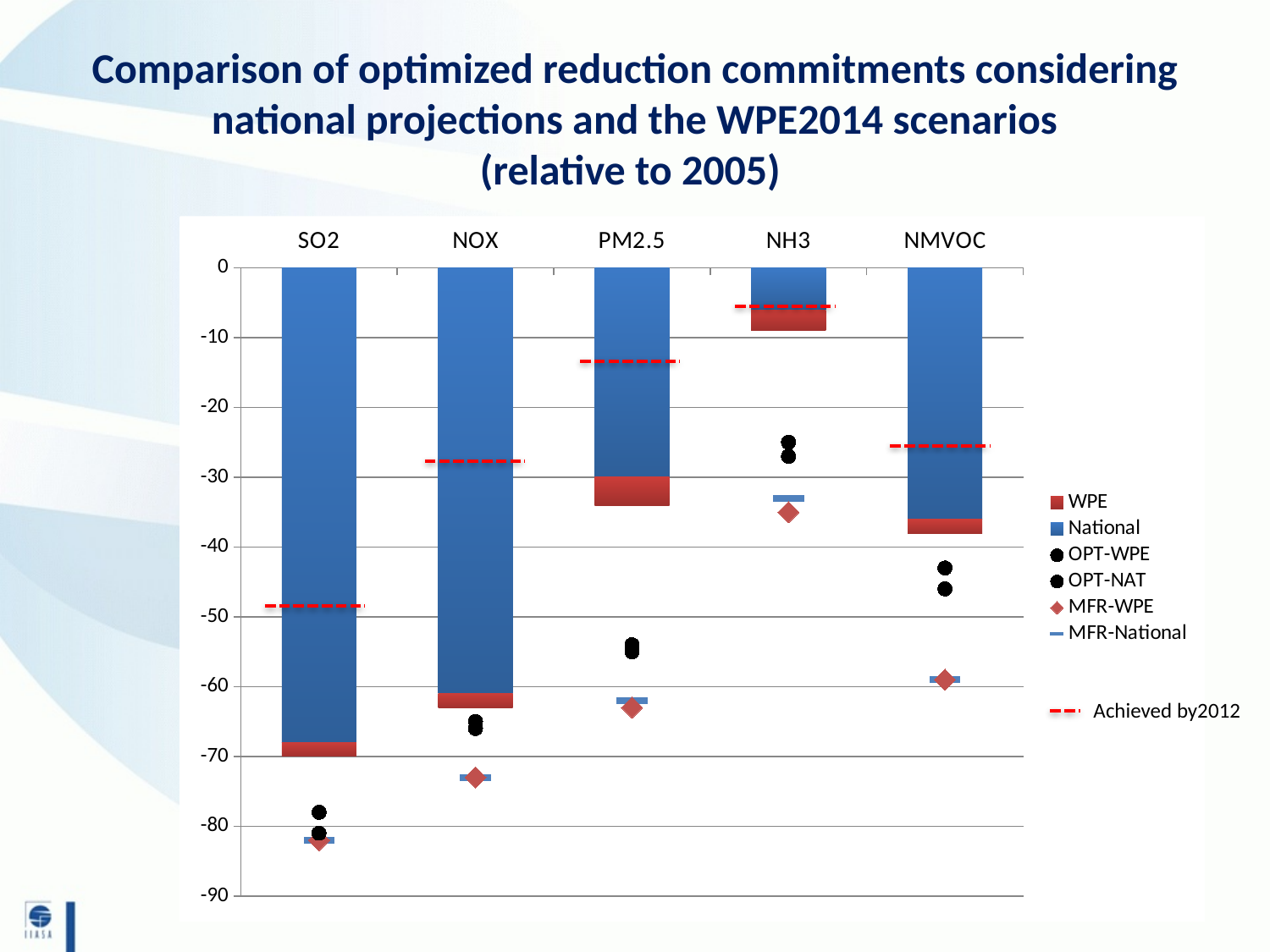
What colour is used for the WPE series in the legend? red Does the National bar for NH3 extend below -10 on the axis? no Does the National bar for SO2 extend below -60 on the axis? yes Which shows a larger reduction for OPT-WPE: SO2 or NMVOC? SO2 Is the 'Achieved by2012' dashed line for NOX above or below -30 on the axis? above How many series does the legend box list (excluding the 'Achieved by2012' line)? 6 Which pollutant has the longest National bar (largest reduction)? SO2 What kind of chart is shown on the slide? bar chart Which shows a larger reduction for MFR-WPE: NOX or PM2.5? NOX Which pollutant has the National bar closest to zero (smallest reduction)? NH3 How many pollutant categories are shown along the x axis? 5